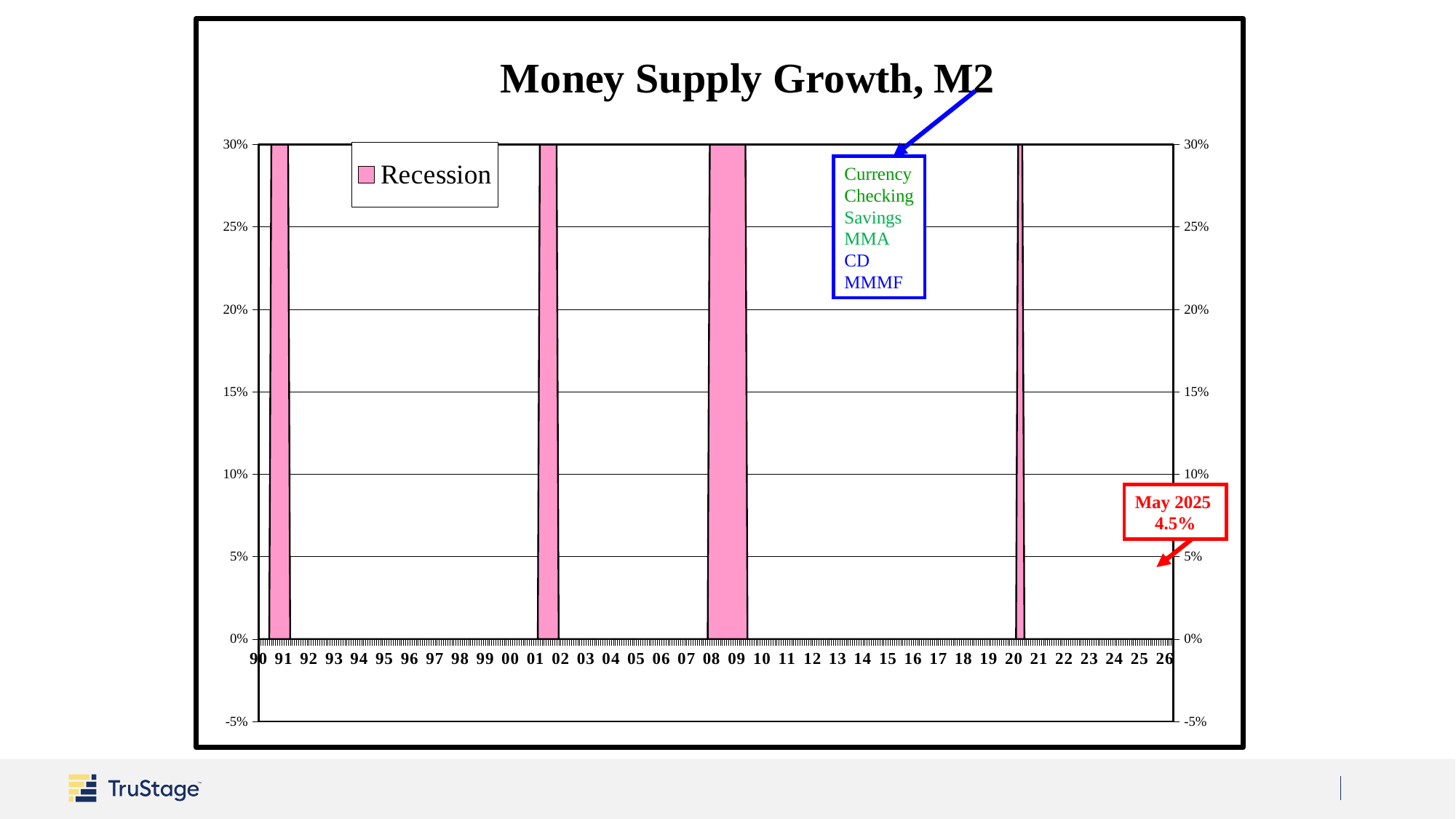
What is the lowest value shown on the vertical axis? -5% What is the highest value shown on the vertical axis? 30% How many shaded recession bars are shown on the chart? 4 What is the title of the chart? Money Supply Growth, M2 Is the May 2025 value of 4.5% greater or less than 5%? less Which recession bar is the widest on the chart? 08-09 What is the first year label on the horizontal axis? 90 How many series does the legend list? 1 What is the last year label on the horizontal axis? 26 What value does the annotation give for May 2025? 4.5%